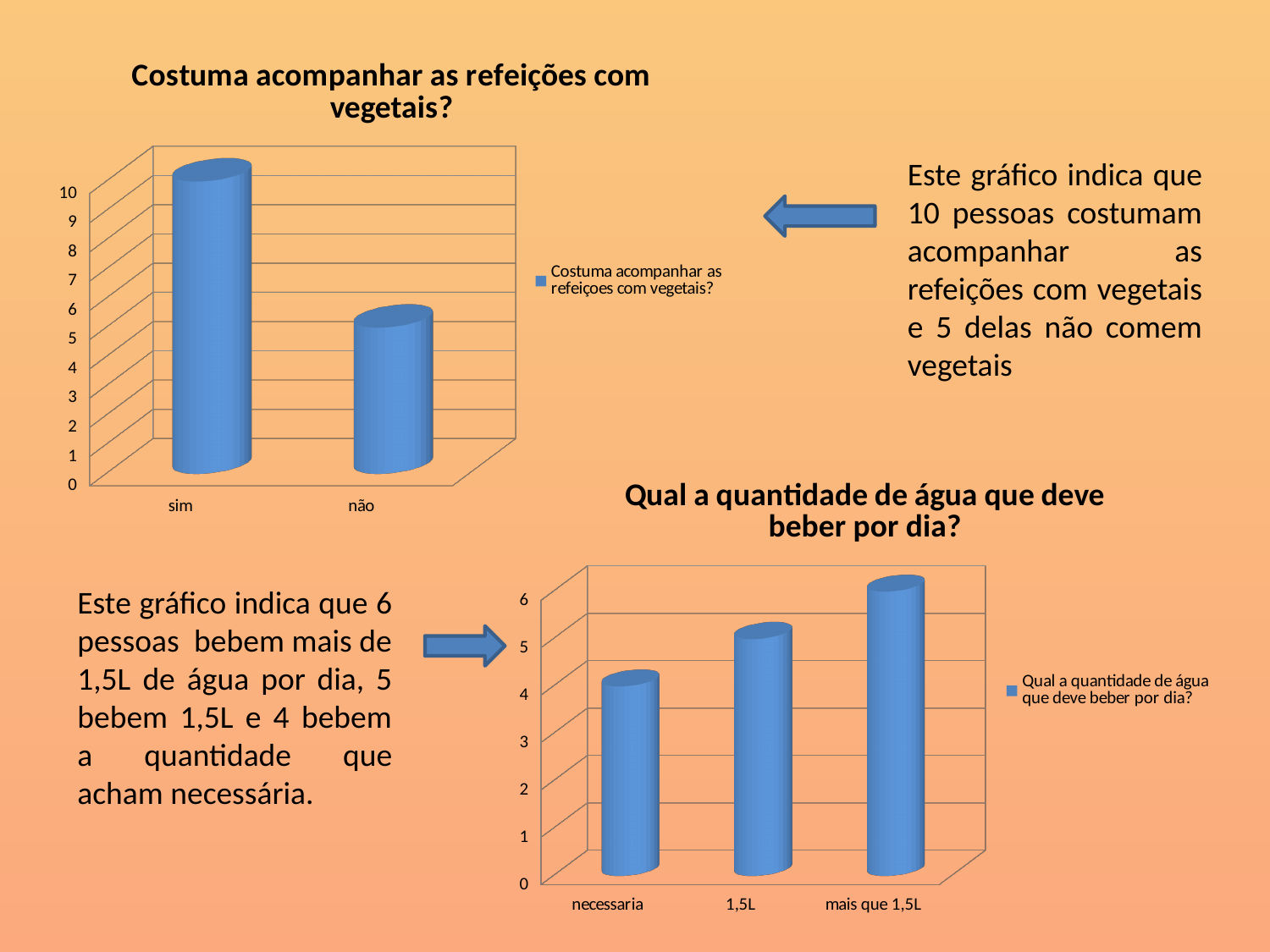
In the chart 'Costuma acompanhar as refeições com vegetais?', what is the value for 'sim'? 10 In the chart 'Qual a quantidade de água que deve beber por dia?', what is the value for 'necessaria'? 4 In the chart 'Qual a quantidade de água que deve beber por dia?', what is the value for 'mais que 1,5L'? 6 In the chart 'Costuma acompanhar as refeições com vegetais?', what is the difference between the values for 'sim' and 'não'? 5 How many series does the legend of the chart 'Qual a quantidade de água que deve beber por dia?' list? 1 In the chart 'Costuma acompanhar as refeições com vegetais?', what is the value for 'não'? 5 What kind of chart is 'Costuma acompanhar as refeições com vegetais?'? bar chart In the chart 'Qual a quantidade de água que deve beber por dia?', is the value for '1,5L' larger or smaller than the value for 'mais que 1,5L'? smaller In the chart 'Costuma acompanhar as refeições com vegetais?', which category has the highest value? sim In the chart 'Qual a quantidade de água que deve beber por dia?', do the values rise or fall from left to right along the x axis? rise In the chart 'Qual a quantidade de água que deve beber por dia?', which category has the lowest value? necessaria In the chart 'Costuma acompanhar as refeições com vegetais?', how many categories are shown on the x axis? 2